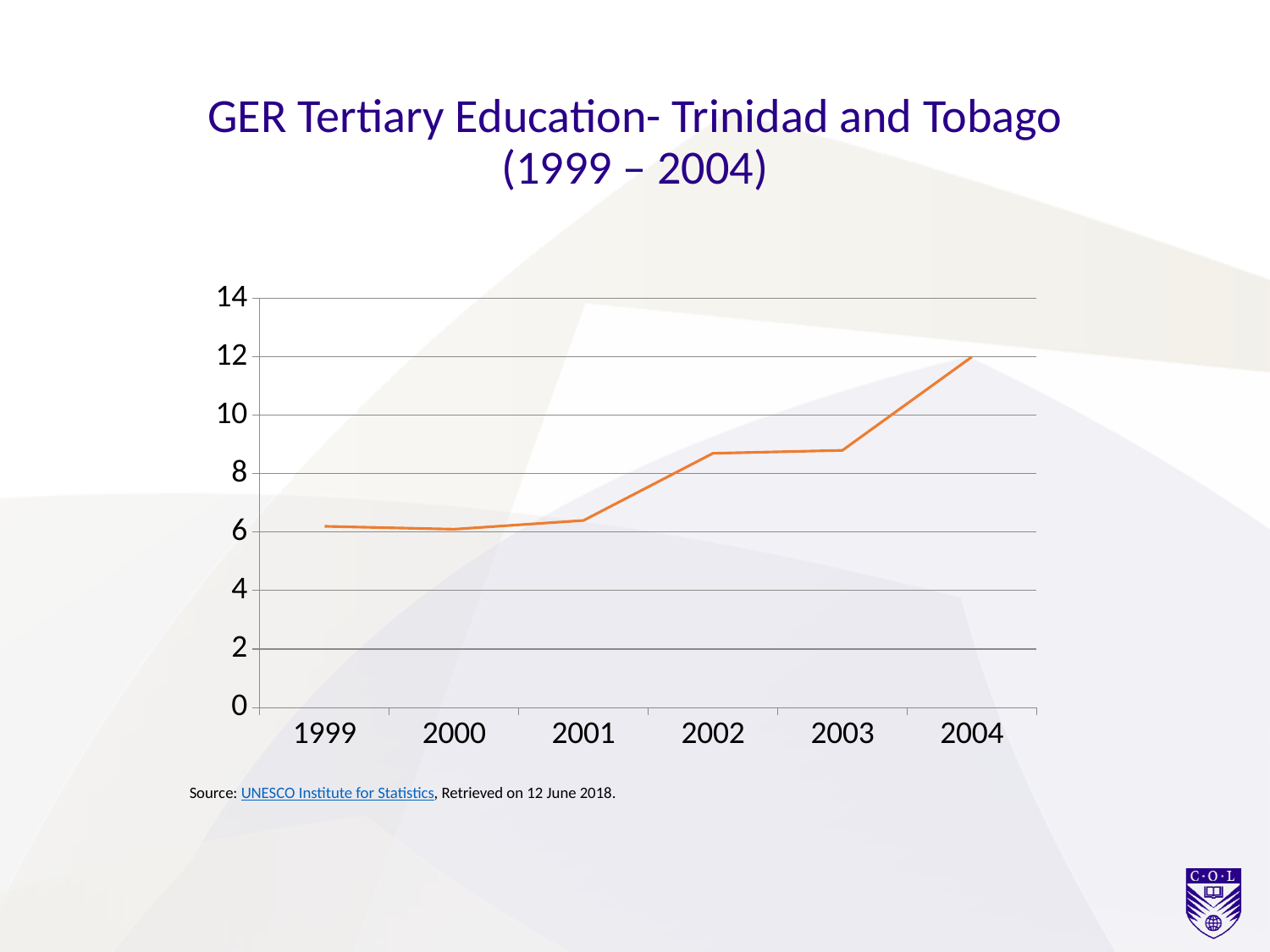
Is the value for 2003 greater or less than 10? less What is the title of the chart? GER Tertiary Education- Trinidad and Tobago (1999 – 2004) Which year has the highest value? 2004 Which is larger, the value for 2001 or the value for 2002? 2002 What is the value for 2004? 12 Do the values generally rise or fall from 1999 to 2004? rise What is the highest value shown on the y axis? 14 Is the value for 1999 greater or less than 8? less What kind of chart is shown on the slide? line chart How many years are plotted on the x axis? 6 Is the value for 2002 greater or less than 8? greater